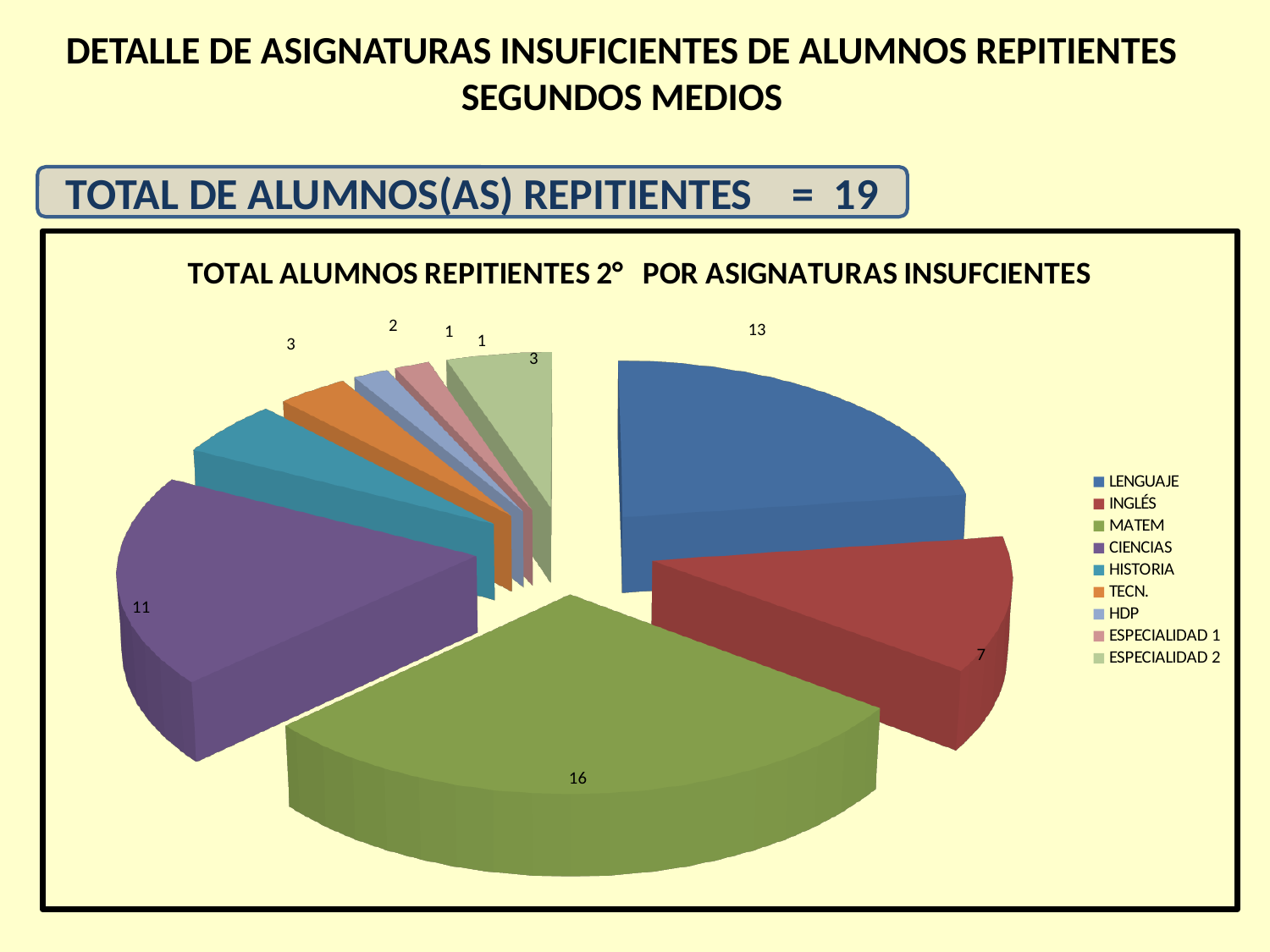
Which subject has the largest slice in the pie chart? MATEM Which colour represents CIENCIAS in the legend? Purple What is the title of the chart? TOTAL ALUMNOS REPITIENTES 2° POR ASIGNATURAS INSUFCIENTES What type of chart is shown on the slide? Pie chart What is the value for INGLÉS in the pie chart? 7 Which is larger, the value for HISTORIA or the value for TECN.? HISTORIA What is the value for LENGUAJE in the pie chart? 13 What is the difference between the values for CIENCIAS and INGLÉS? 4 How many subjects (slices) does the pie chart show? 9 What is the value for CIENCIAS in the pie chart? 11 What is the value for MATEM in the pie chart? 16 What is the difference between the values for MATEM and LENGUAJE? 3